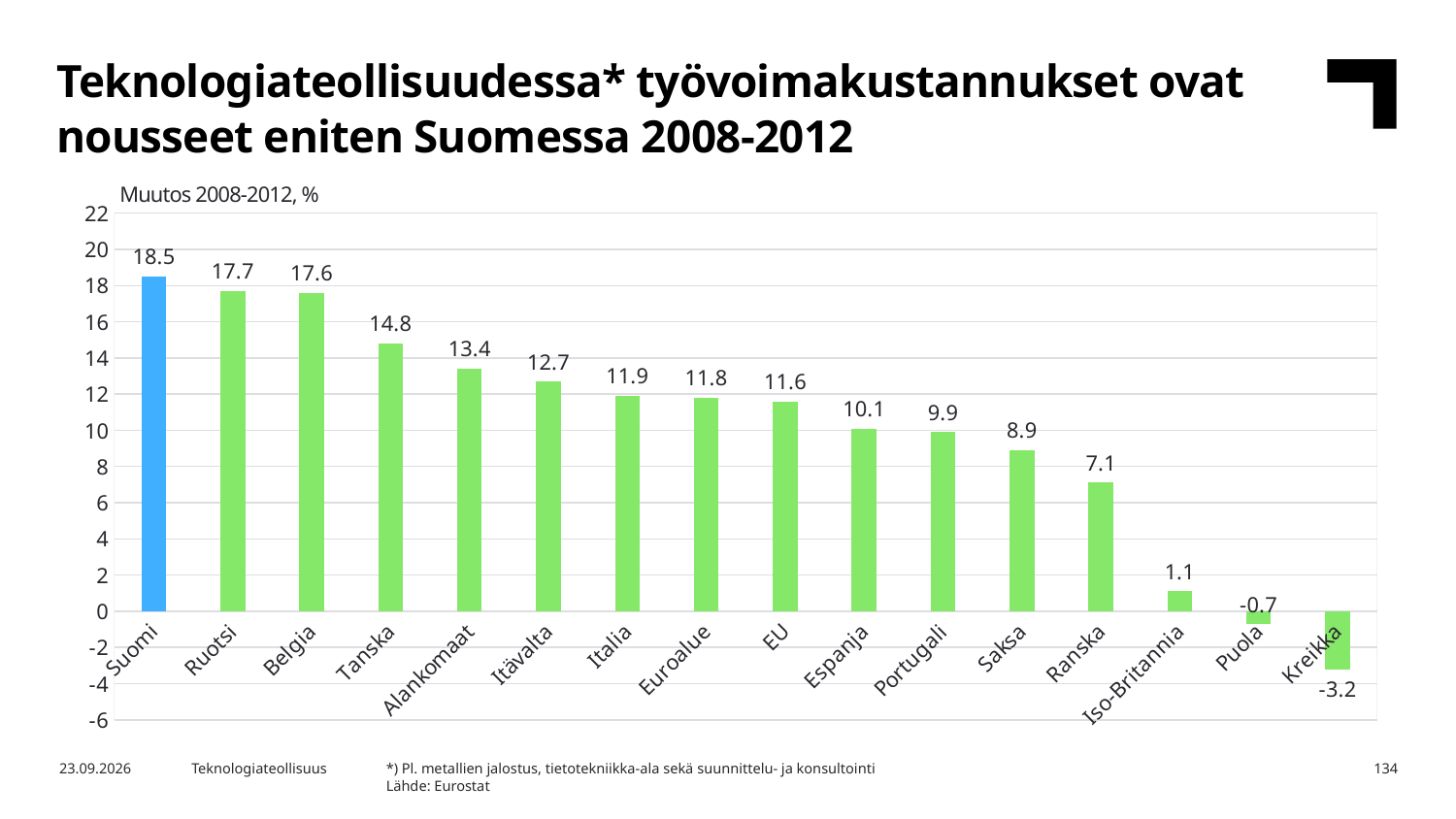
Which country has the highest value? Suomi What is the value for Alankomaat? 13.4 What is the value for Kreikka? -3.2 What is the value for Iso-Britannia? 1.1 Which country has the lowest value? Kreikka How many countries or regions are shown on the chart? 16 What is the value for Suomi? 18.5 What is the difference between the values for Tanska and Saksa? 5.9 What is the axis label shown above the chart? Muutos 2008-2012, % What is the difference between the values for Suomi and Ruotsi? 0.8 What kind of chart is shown on the slide? Bar chart Which is larger, the value for Espanja or the value for Ranska? Espanja